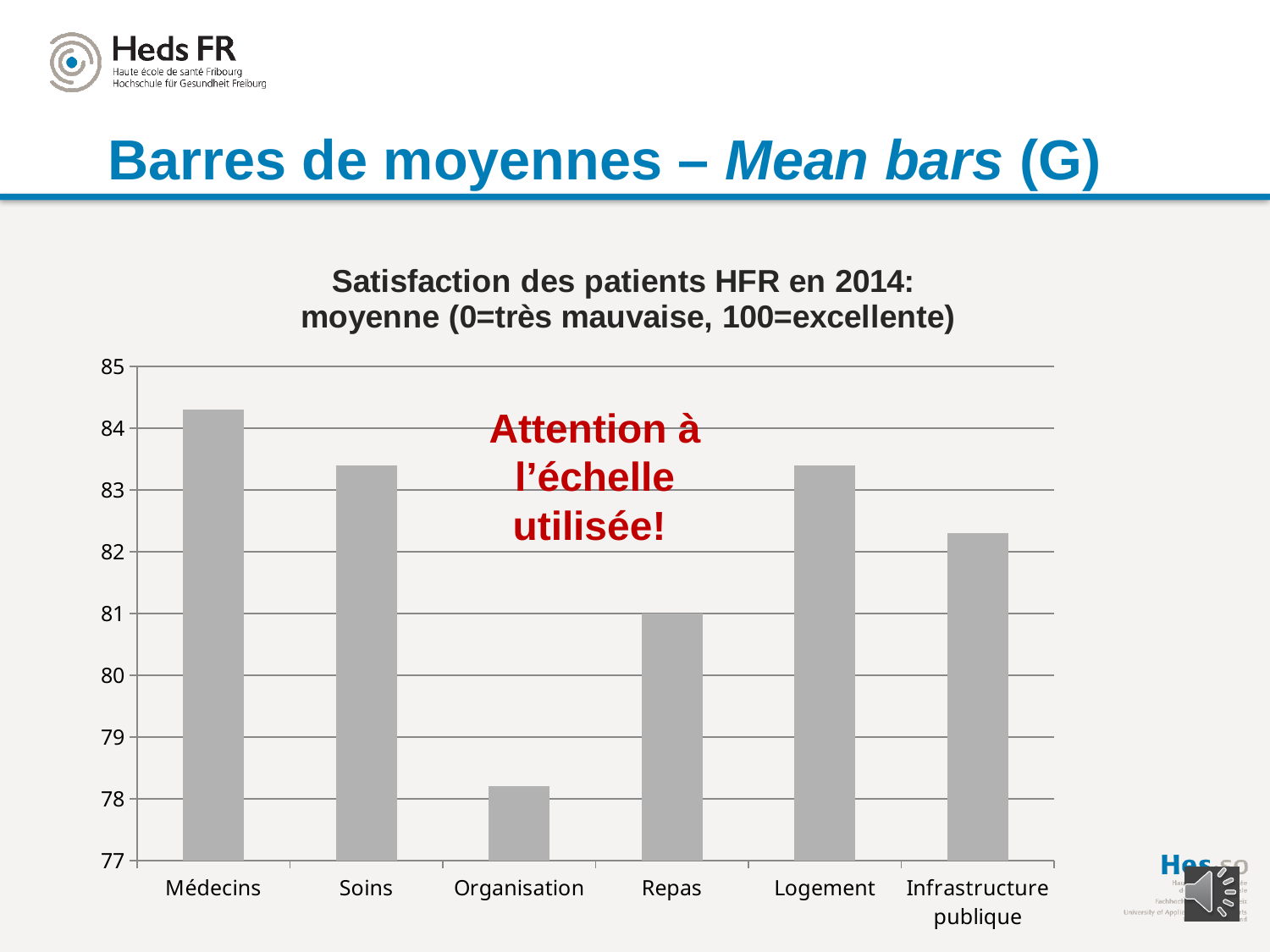
What is the lowest value shown on the vertical axis of the chart? 77 Is the value for Organisation greater or less than 79? less What kind of chart is shown on the slide? bar chart How many categories are shown on the x axis of the chart? 6 Is the value for Soins greater or less than 83? greater What is the title of the chart? Satisfaction des patients HFR en 2014: moyenne (0=très mauvaise, 100=excellente) Is the value for Médecins greater or less than 84? greater Which category has the highest mean satisfaction score? Médecins Which category has the lowest mean satisfaction score? Organisation Which is larger, the value for Médecins or the value for Repas? Médecins Which is larger, the value for Organisation or the value for Repas? Repas